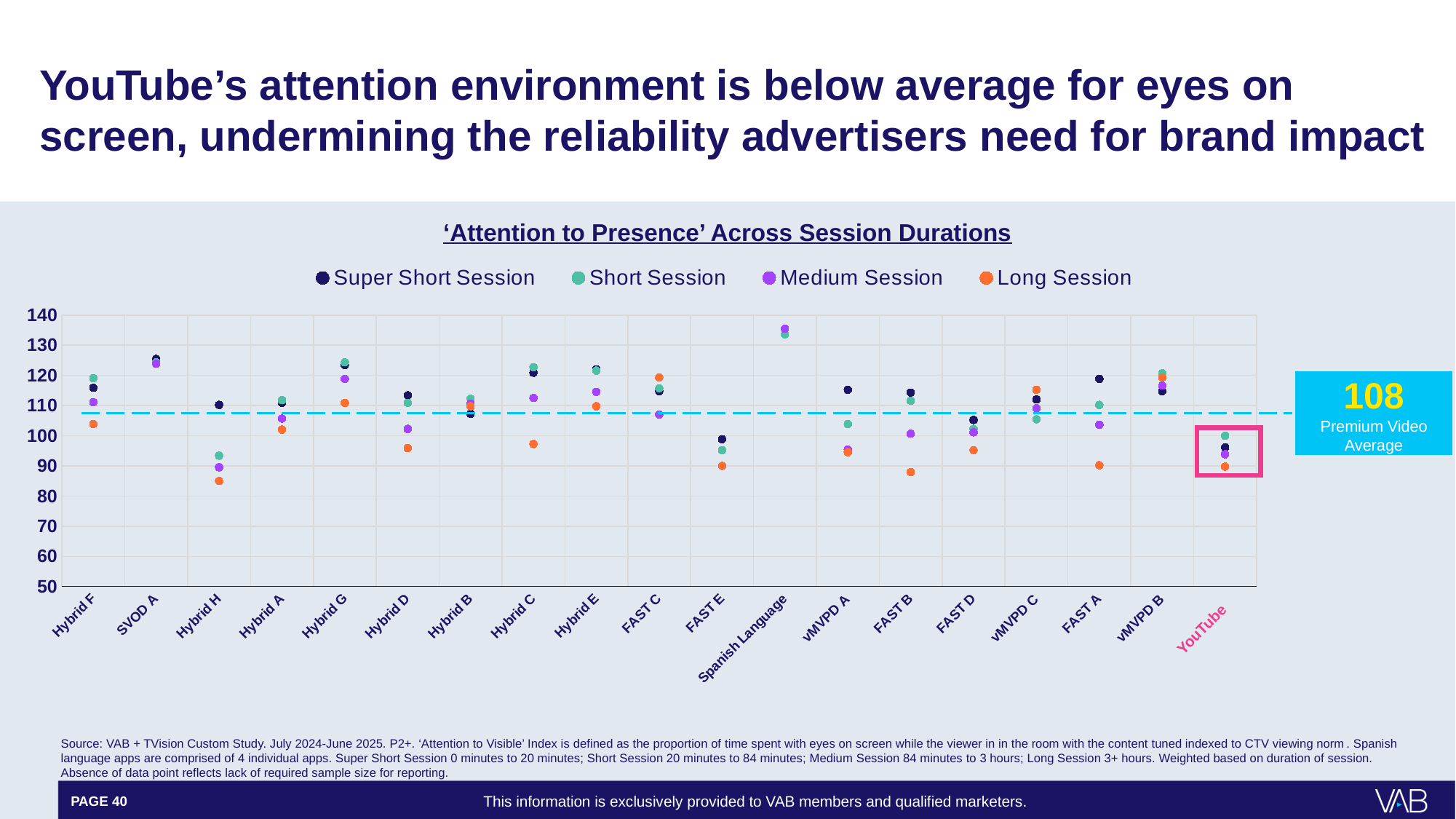
Is the Short Session value for Spanish Language greater or less than 130? greater How many series does the legend list? 4 What kind of chart is this? Scatter (dot) chart Is the Long Session value for YouTube greater or less than 100? less Is the Short Session value for Hybrid G greater or less than 120? greater Which is larger, the Long Session value for FAST C or the Long Session value for FAST E? FAST C How many categories are shown along the x axis? 19 What is the Premium Video Average value shown on the chart? 108 Which category label on the x axis is highlighted in pink? YouTube Which category has the highest Medium Session value? Spanish Language